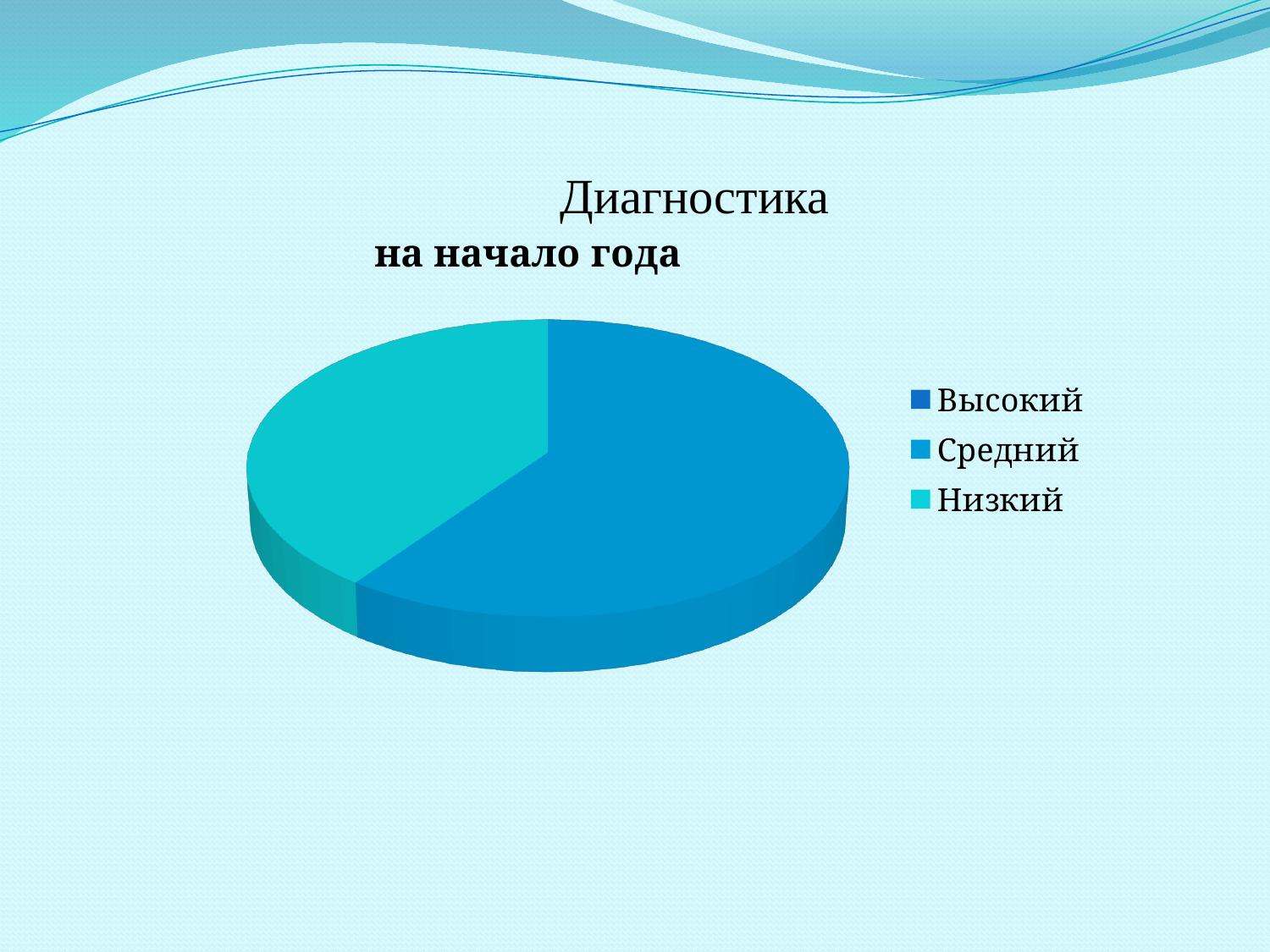
What is the title of the chart on the slide? на начало года Which legend entry is shown in the lightest (teal) colour? Низкий How many entries does the legend of the pie chart list? 3 Is the share of the Средний slice greater or less than 50%? greater Which category has the largest slice in the pie chart? Средний What kind of chart is shown on the slide? pie chart Is the share of the Низкий slice greater or less than 50%? less Which slice is larger, Средний or Низкий? Средний